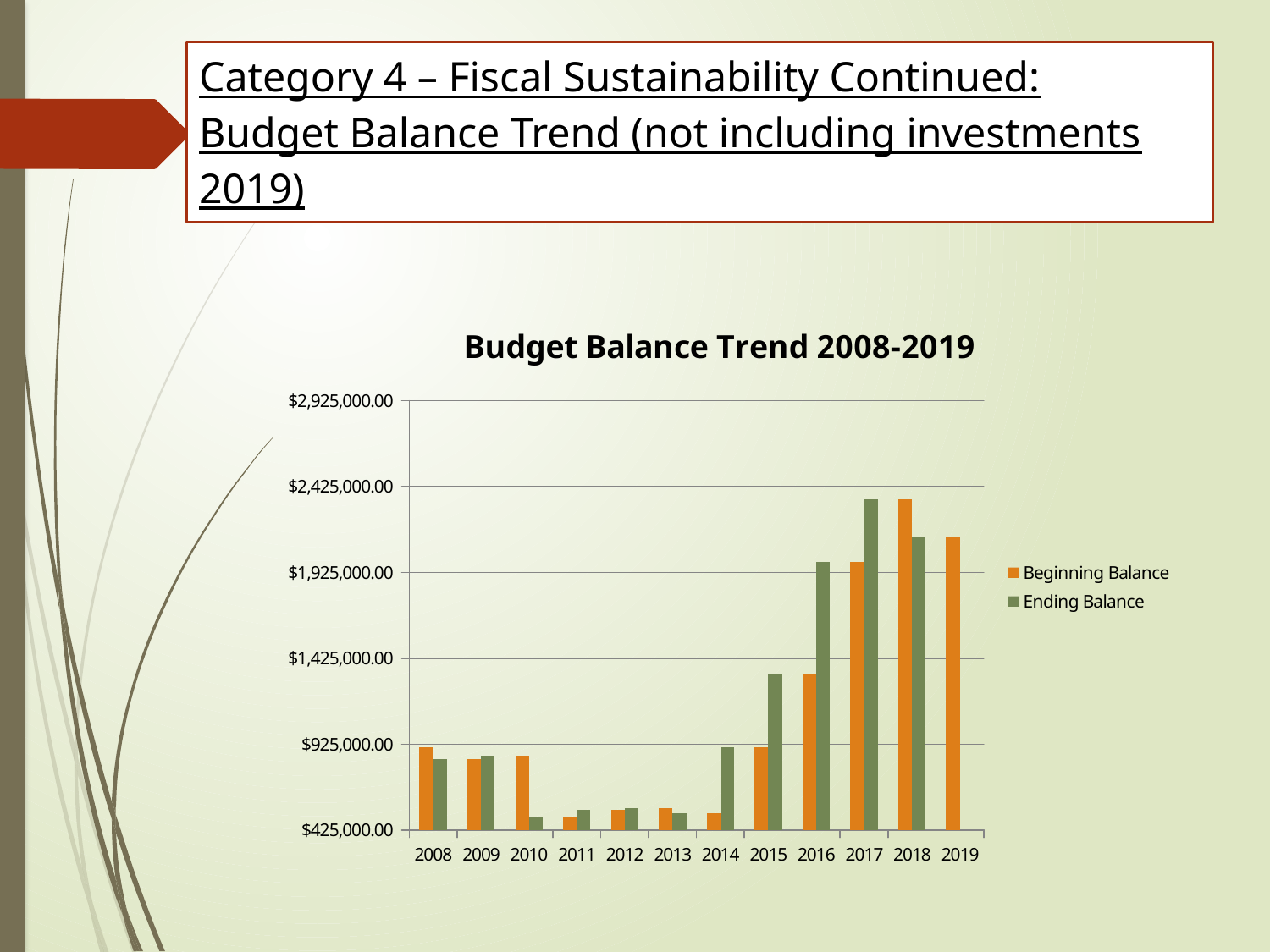
Which year has the highest Beginning Balance? 2018 In 2018, which is larger, the Beginning Balance or the Ending Balance? Beginning Balance Is the Beginning Balance for 2019 greater or less than $1,925,000.00? greater How many series does the chart's legend list? 2 Is the Ending Balance for 2015 greater or less than $1,425,000.00? less In 2017, which is larger, the Beginning Balance or the Ending Balance? Ending Balance What kind of chart is shown on the slide? Bar chart What is the title of the chart? Budget Balance Trend 2008-2019 Which year has the lowest Beginning Balance? 2011 Which year has the lowest Ending Balance? 2010 How many years are shown on the x axis of the chart? 12 Which year has the highest Ending Balance? 2017